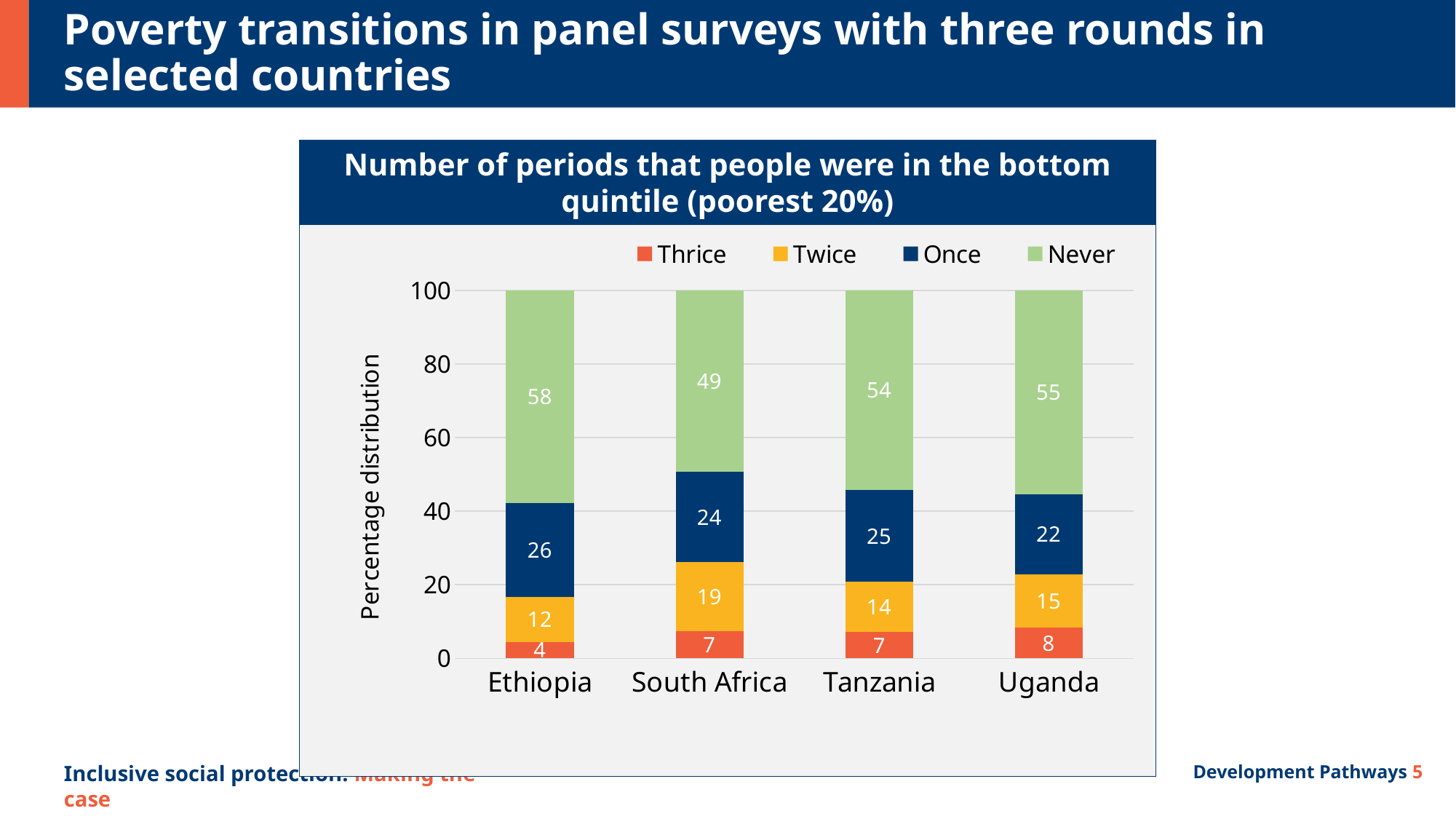
What is the total of the stacked bar for Tanzania? 100 What is the value for Twice in South Africa? 19 How many series does the legend list? 4 Which is larger, the Twice value for South Africa or the Twice value for Uganda? South Africa Which country has the highest value for Never? Ethiopia What is the value for Never in Ethiopia? 58 What is the difference between the Never values for Ethiopia and South Africa? 9 How many countries are shown on the x axis? 4 What is the value for Thrice in Uganda? 8 What kind of chart is this? Stacked bar chart Which country has the lowest value for Thrice? Ethiopia What is the value for Once in Tanzania? 25